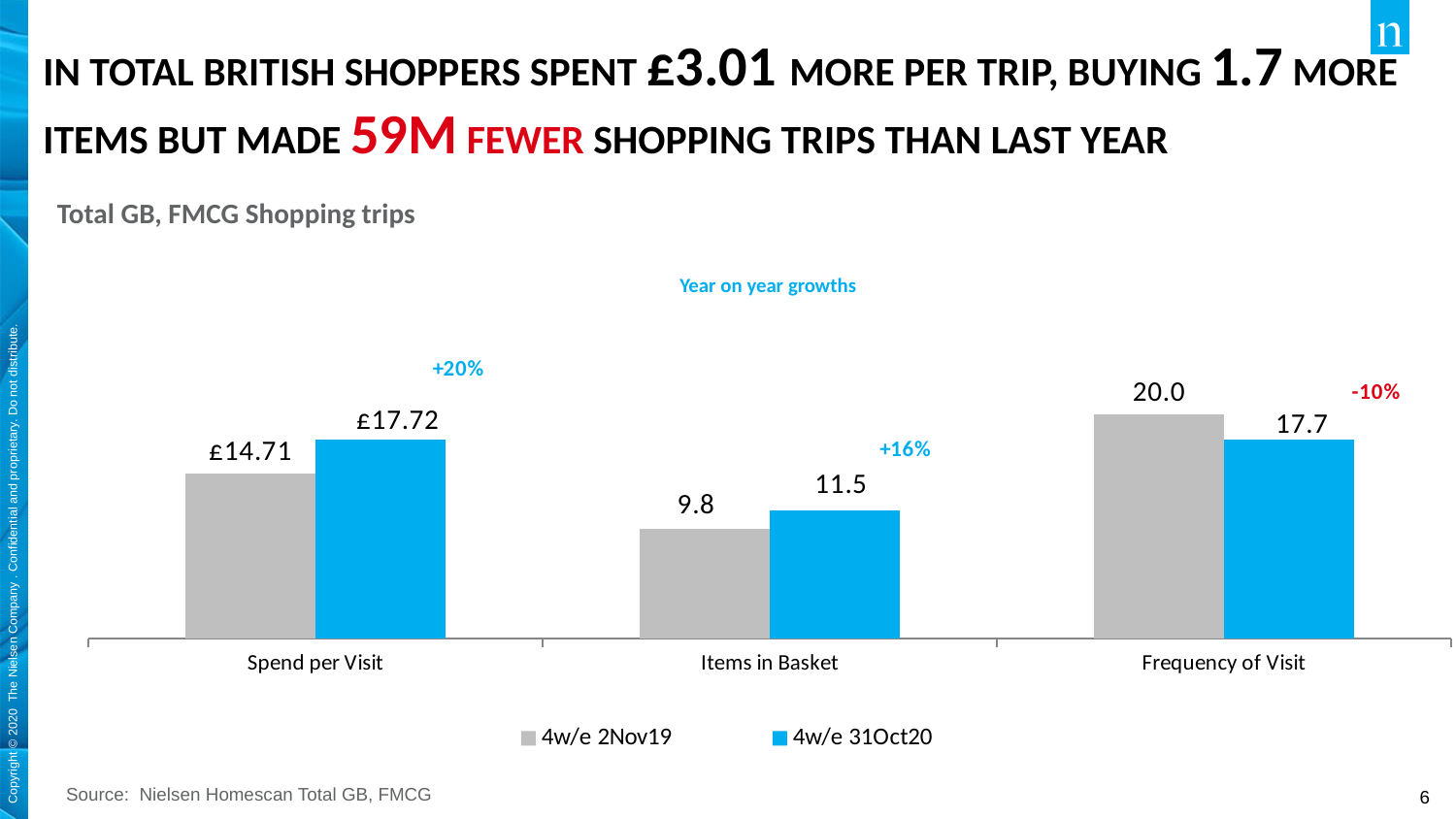
What is the Spend per Visit value for 4w/e 31Oct20? £17.72 How many series does the chart legend list? 2 For Frequency of Visit, which period has the larger value, 4w/e 2Nov19 or 4w/e 31Oct20? 4w/e 2Nov19 How many categories are shown on the x axis of the chart? 3 What type of chart is shown on the slide? Bar chart What is the Frequency of Visit value for 4w/e 31Oct20? 17.7 What year-on-year growth is shown for Items in Basket? +16% What is the Spend per Visit value for 4w/e 2Nov19? £14.71 What is the difference between the 4w/e 2Nov19 and 4w/e 31Oct20 values for Frequency of Visit? 2.3 What is the difference between the 4w/e 31Oct20 and 4w/e 2Nov19 values for Spend per Visit? £3.01 What is the Items in Basket value for 4w/e 2Nov19? 9.8 What year-on-year growth is shown for Frequency of Visit? -10%